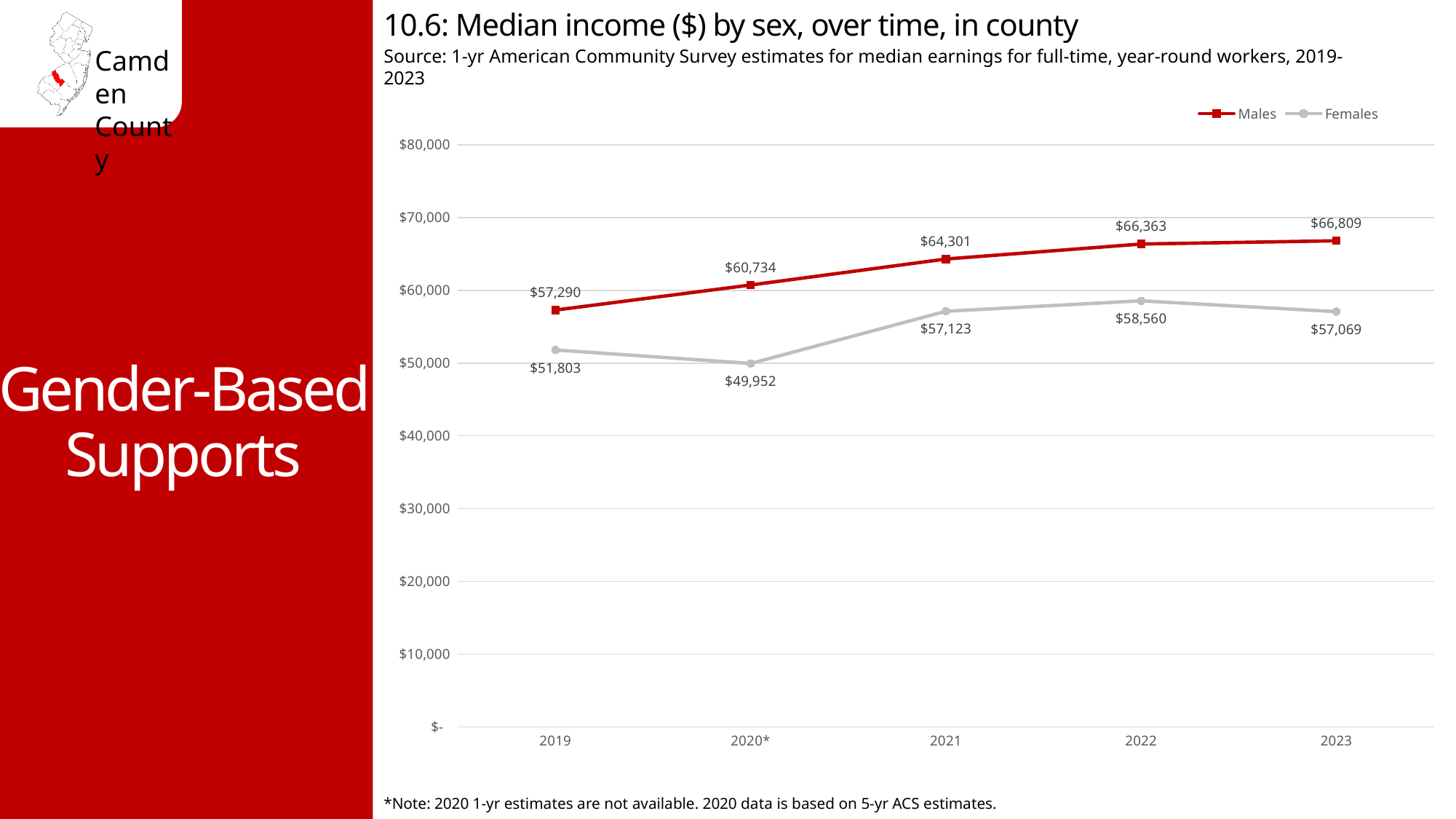
What is the difference between the Males and Females median income in 2023? $9,740 What is the median income for Males in 2021? $64,301 Which is larger, the Females median income in 2022 or in 2021? 2022 Does the Males median income rise or fall from 2019 to 2023? Rise What is the median income for Females in 2020*? $49,952 How many years are shown on the x axis? 5 How many series does the legend list? 2 What is the difference between the Males median income in 2019 and in 2023? $9,519 In which year is the Males median income highest? 2023 In which year is the Females median income lowest? 2020* What kind of chart is this? Line chart What is the median income for Females in 2023? $57,069